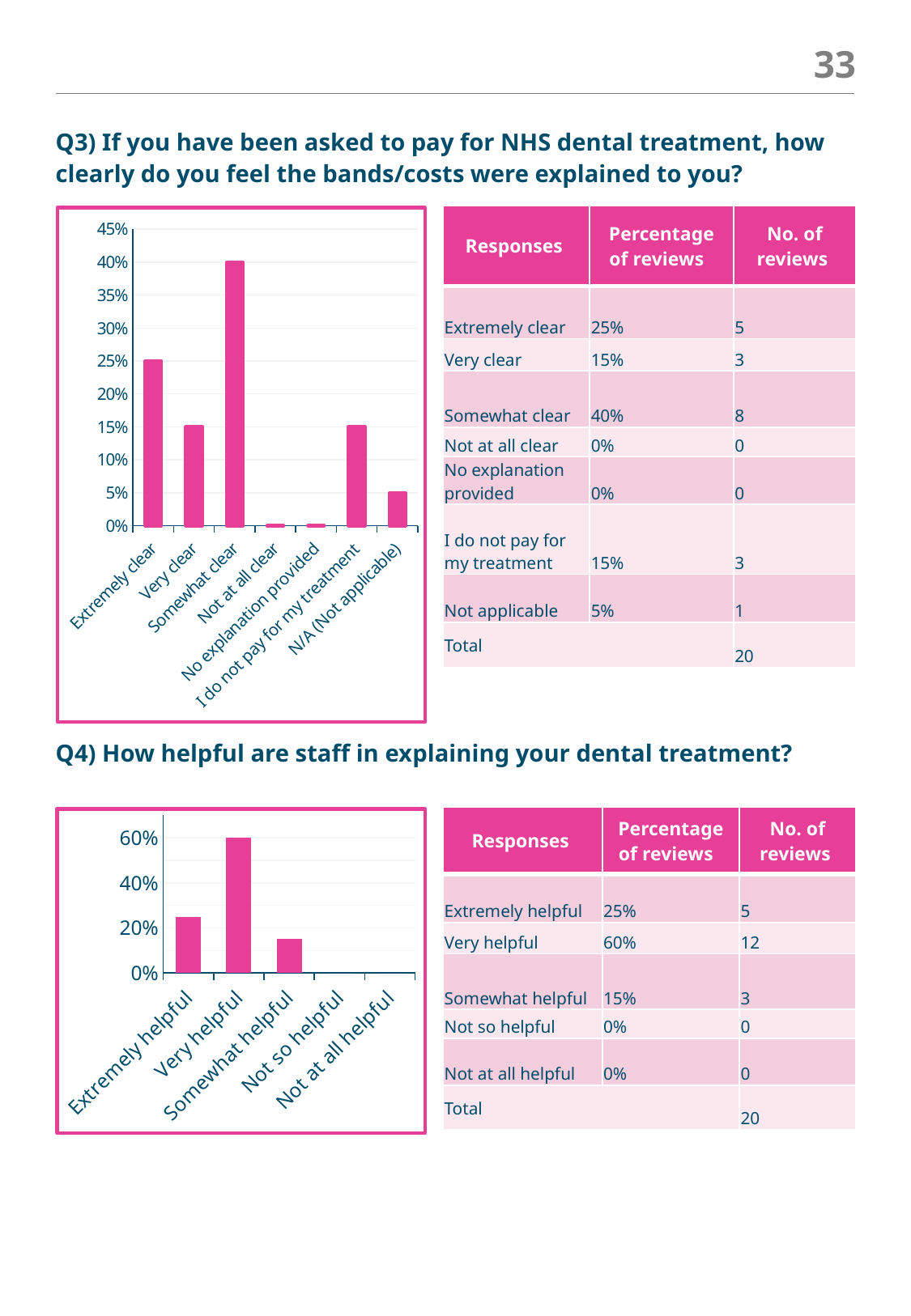
In the Q3 chart (top), is the value for Somewhat clear greater or less than 35%? greater In the Q4 chart (bottom), which category has the highest bar? Very helpful In the Q3 chart (top), what is the value for Extremely clear? 25% In the Q3 chart (top), which is larger, Very clear or N/A (Not applicable)? Very clear In the Q3 chart (top), what is the value for N/A (Not applicable)? 5% What type of chart is used for Q4 (bottom)? Bar chart In the Q3 chart (top), which category has the highest bar? Somewhat clear In the Q4 chart (bottom), what is the value for Very helpful? 60% In the Q3 chart (top), what is the difference between Somewhat clear and Extremely clear? 15% In the Q4 chart (bottom), how many categories are shown on the x axis? 5 In the Q3 chart (top), how many categories are shown on the x axis? 7 In the Q4 chart (bottom), what is the difference between Very helpful and Somewhat helpful? 45%